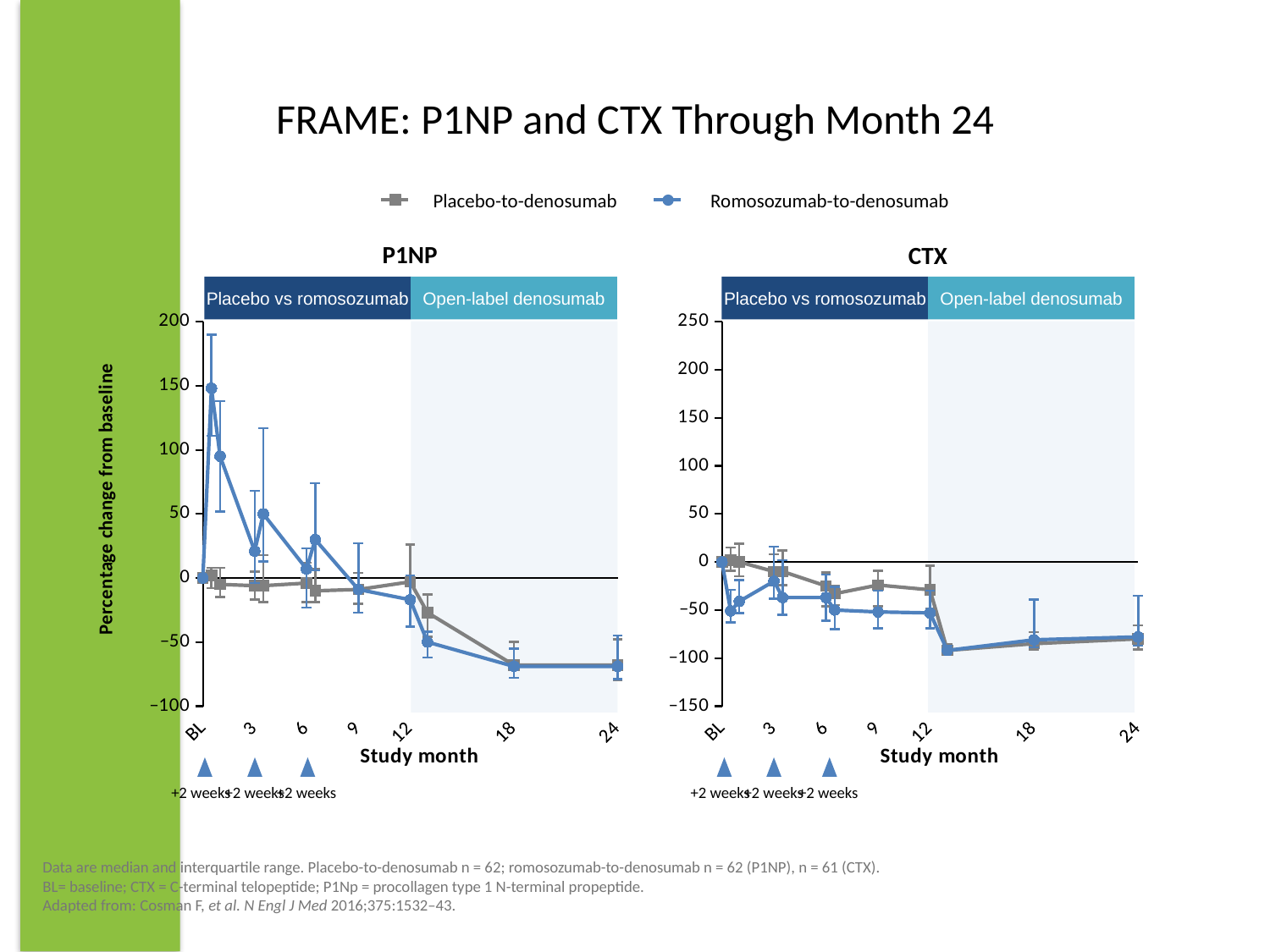
In the P1NP chart, is the Placebo-to-denosumab value at month 12 + 2 weeks greater or less than -50? greater How many series does the legend list? 2 In the P1NP chart, is the Romosozumab-to-denosumab value at month 18 greater or less than -50? less In the CTX chart, is the Placebo-to-denosumab value at month 12 + 2 weeks greater or less than -50? less What are the two study phases labelled above each chart? Placebo vs romosozumab and Open-label denosumab What kind of chart is used for the P1NP panel? line chart In the CTX chart, does the Romosozumab-to-denosumab series rise or fall from month 12 to month 12 + 2 weeks? fall How many study month tick labels are shown on the x axis of the CTX chart? 7 In the CTX chart, at BL + 2 weeks, which series has the larger value, Placebo-to-denosumab or Romosozumab-to-denosumab? Placebo-to-denosumab What are the two series named in the legend? Placebo-to-denosumab and Romosozumab-to-denosumab In the P1NP chart, at BL + 2 weeks, which series has the larger value, Placebo-to-denosumab or Romosozumab-to-denosumab? Romosozumab-to-denosumab In the P1NP chart, at which time point does the Romosozumab-to-denosumab series reach its highest value? BL + 2 weeks